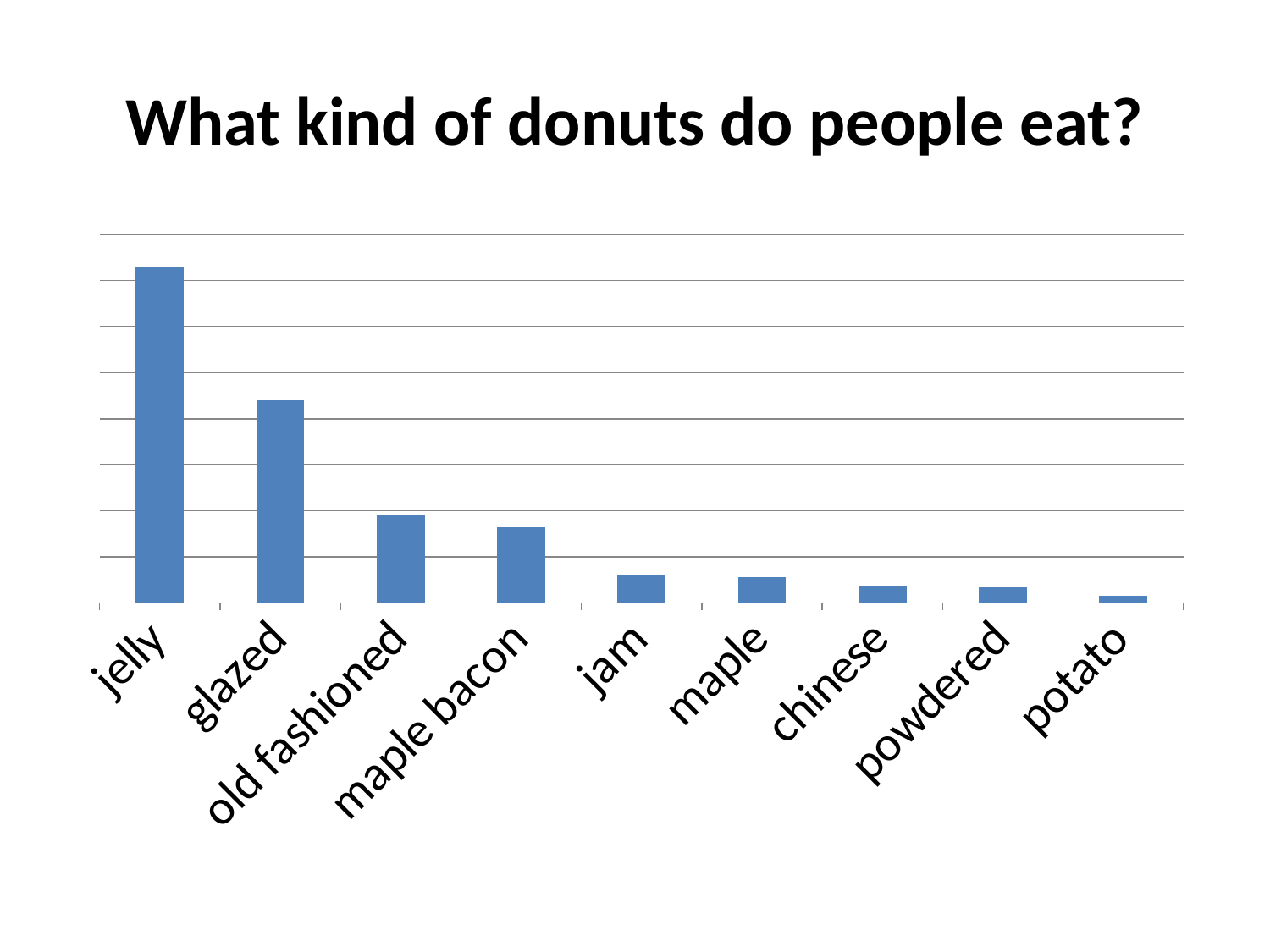
How many donut categories are shown on the x axis? 9 Which donut category has the highest bar? jelly Which has a higher value, old fashioned or maple bacon? old fashioned Which has a higher value, powdered or potato? powdered Which has a higher value, jelly or glazed? jelly Which category is the second highest? glazed What is the title of the chart? What kind of donuts do people eat? Do the bar values rise or fall moving from left to right along the x axis? fall What kind of chart is shown on the slide? bar chart Which donut category has the lowest bar? potato